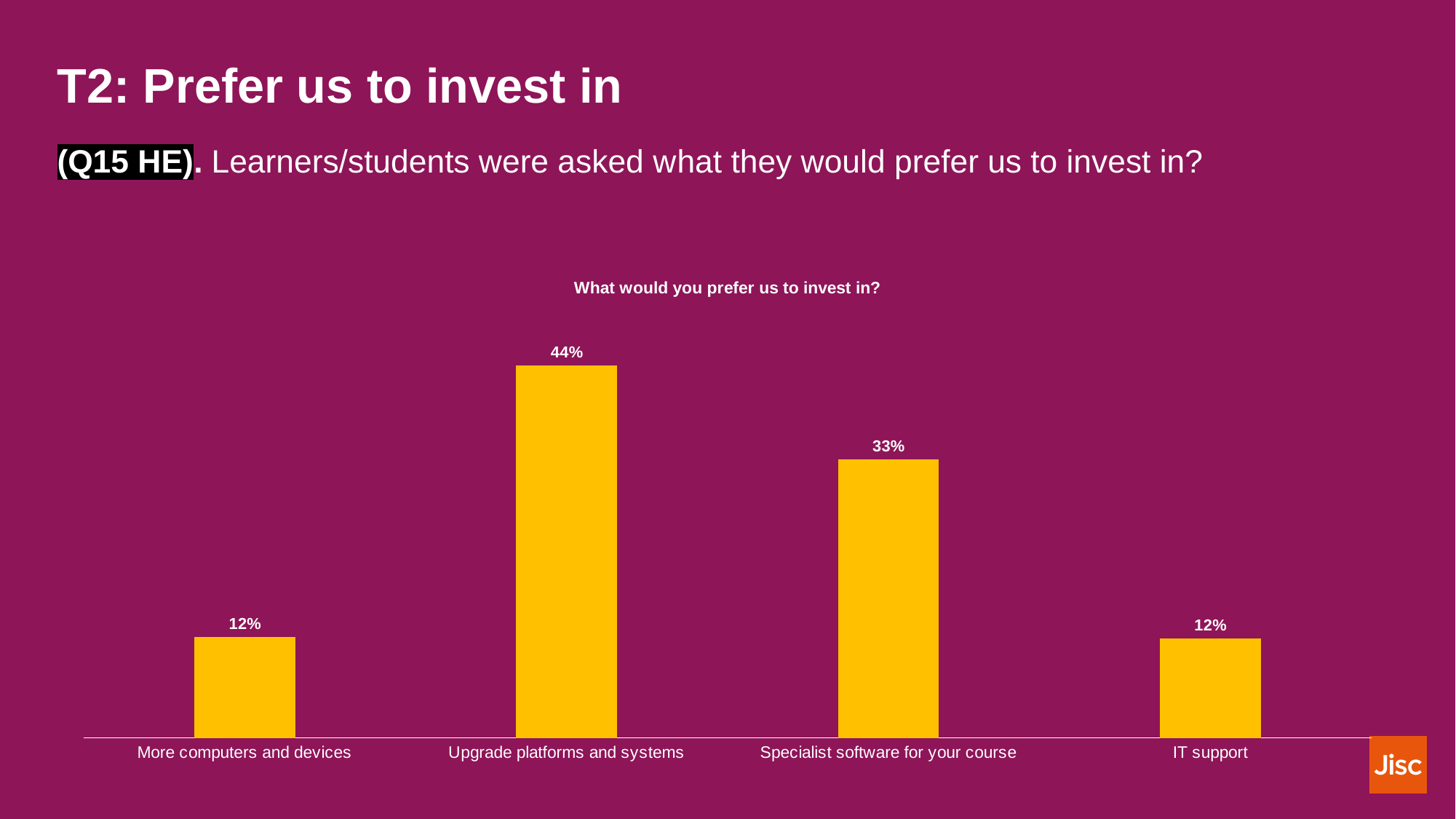
What is the difference between 'Upgrade platforms and systems' and 'Specialist software for your course'? 11% What is the difference between 'Specialist software for your course' and 'IT support'? 21% What is the title of the chart? What would you prefer us to invest in? What percentage of learners/students preferred investment in 'Upgrade platforms and systems'? 44% Which category has the highest value? Upgrade platforms and systems What is the value shown for 'IT support'? 12% What is the value shown for 'Specialist software for your course'? 33% How many categories are shown on the chart? 4 What kind of chart is shown on the slide? Bar chart What is the value shown for 'More computers and devices'? 12% Which is larger: 'Upgrade platforms and systems' or 'Specialist software for your course'? Upgrade platforms and systems Which two categories share the same value of 12%? More computers and devices; IT support